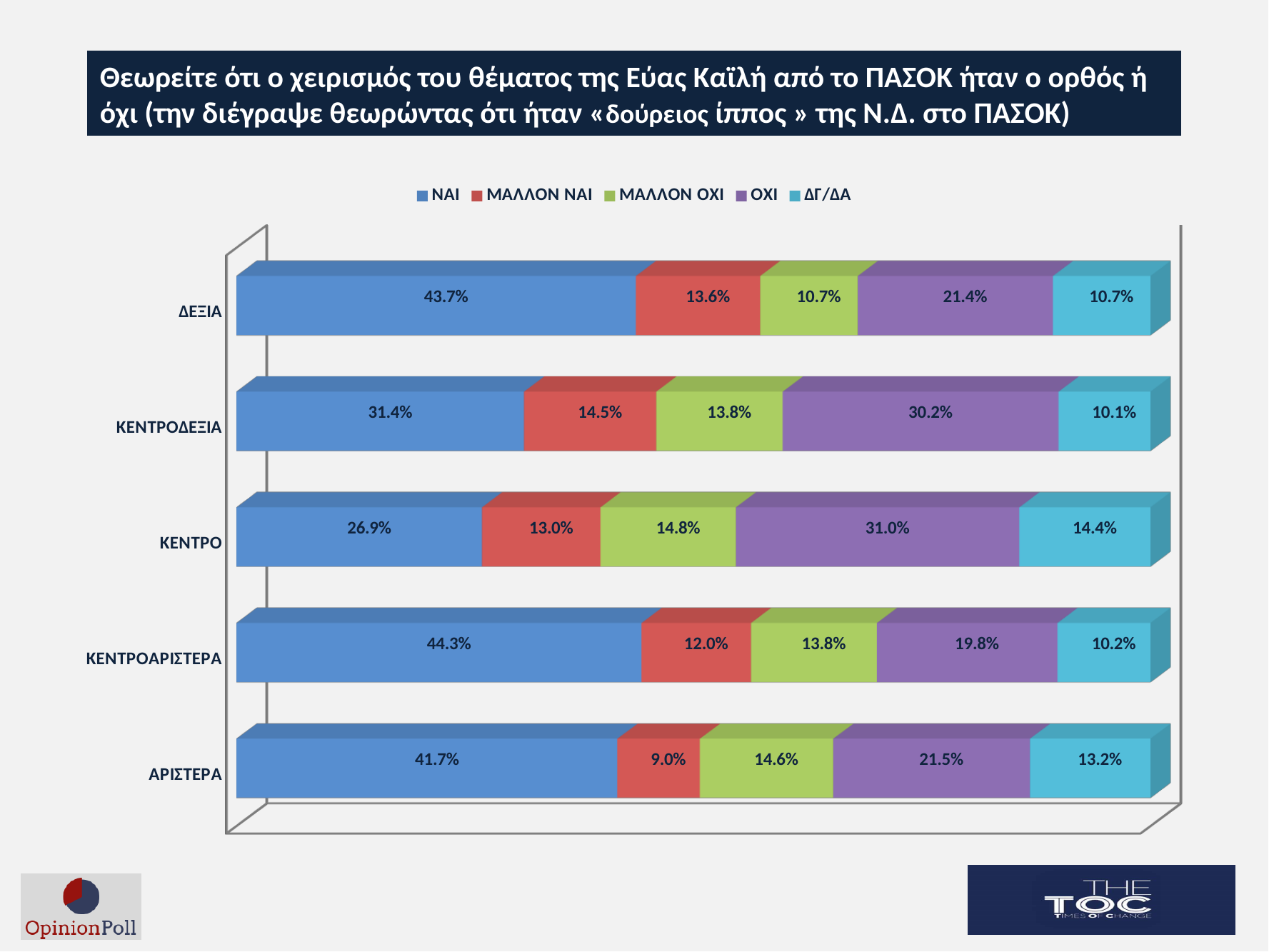
What is the ΝΑΙ value for ΔΕΞΙΑ? 43.7% How many categories (political groups) are shown on the chart? 5 What is the ΔΓ/ΔΑ value for ΚΕΝΤΡΟ? 14.4% For ΚΕΝΤΡΟ, which is larger: the ΝΑΙ value or the ΟΧΙ value? ΟΧΙ What type of chart is shown on the slide? Stacked bar chart What is the difference between the ΝΑΙ and ΟΧΙ values for ΔΕΞΙΑ? 22.3% What is the ΜΑΛΛΟΝ ΟΧΙ value for ΑΡΙΣΤΕΡΑ? 14.6% Which category has the lowest ΝΑΙ value? ΚΕΝΤΡΟ How many series does the legend list? 5 Which category has the lowest ΜΑΛΛΟΝ ΝΑΙ value? ΑΡΙΣΤΕΡΑ What is the ΟΧΙ value for ΚΕΝΤΡΟΔΕΞΙΑ? 30.2% Which category has the highest ΝΑΙ value? ΚΕΝΤΡΟΑΡΙΣΤΕΡΑ